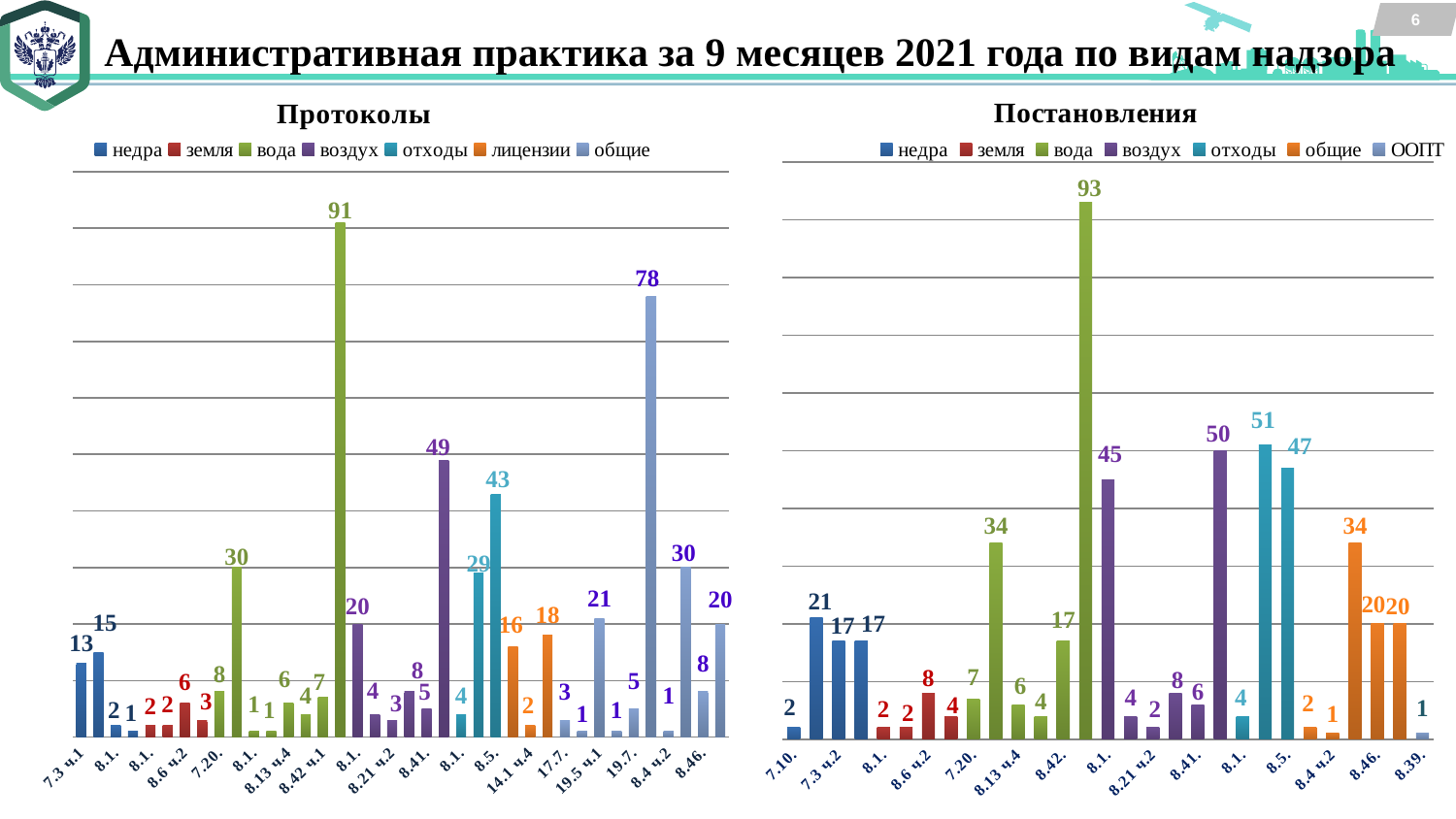
In the 'Протоколы' chart, what is the highest value among the 'воздух' bars? 49 In the 'Протоколы' chart, which is larger: the tallest 'вода' bar or the tallest 'общие' bar? вода In the 'Постановления' chart, what is the highest value among the 'общие' bars? 34 What is the last legend entry of the 'Постановления' chart? ООПТ How many series does the legend of the 'Постановления' chart list? 7 What kind of chart is the 'Протоколы' chart on the left? bar chart In the 'Протоколы' chart, what is the value of the tallest bar? 91 How many series does the legend of the 'Протоколы' chart list? 7